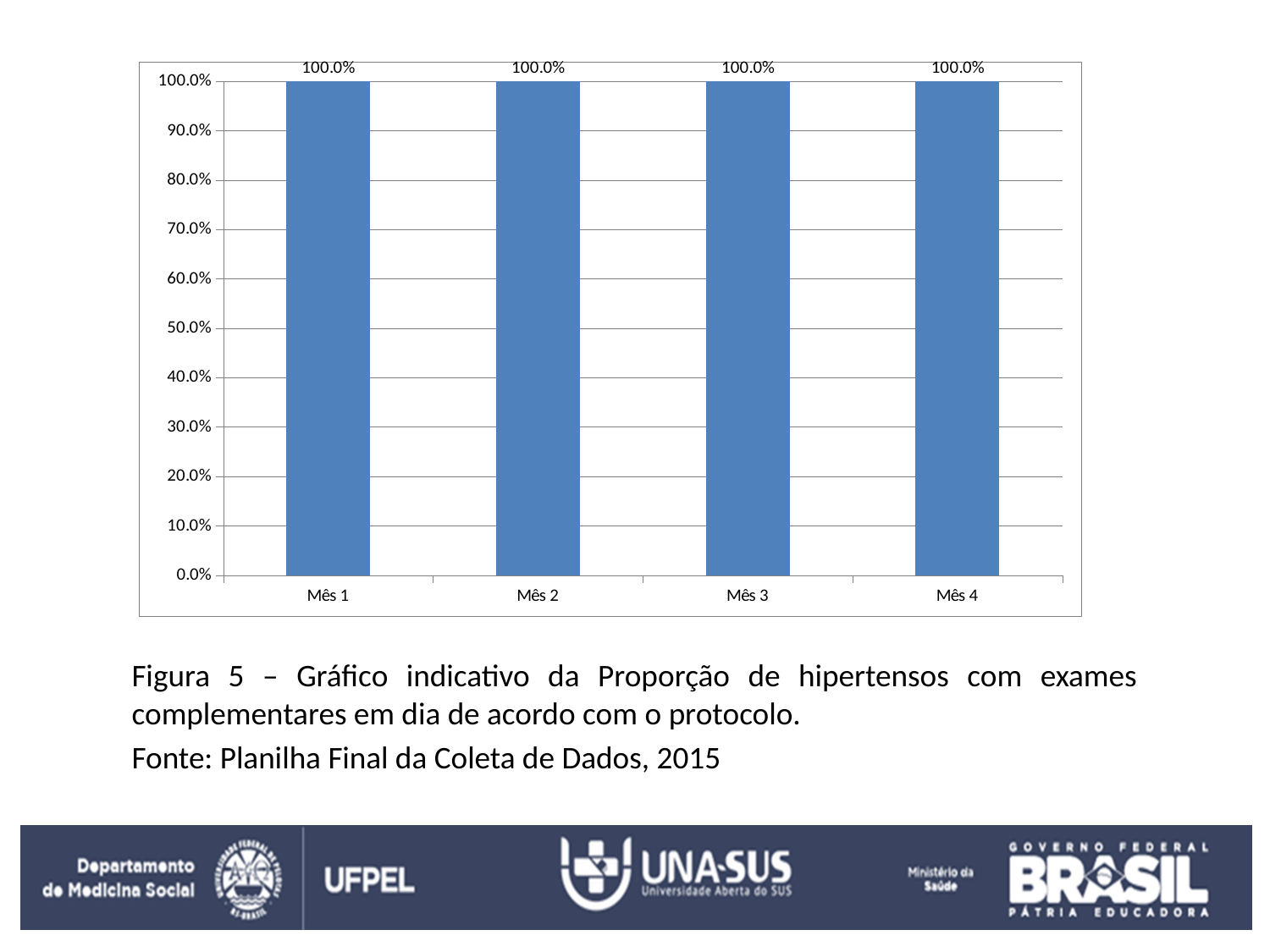
According to the caption, what is the source of the data in Figura 5? Planilha Final da Coleta de Dados, 2015 What is the value for Mês 4? 100.0% What is the value for Mês 1? 100.0% What is the difference between the values for Mês 2 and Mês 4? 0.0% Do the values rise, fall or stay the same from Mês 1 to Mês 4? Stay the same What is the highest value shown on the y axis? 100.0% What is the value for Mês 3? 100.0% What kind of chart is shown on the slide? Bar chart How many categories (months) are shown on the x axis? 4 Is the value for Mês 1 larger than, smaller than or equal to the value for Mês 2? Equal Is the value for Mês 3 greater or less than 90.0%? greater